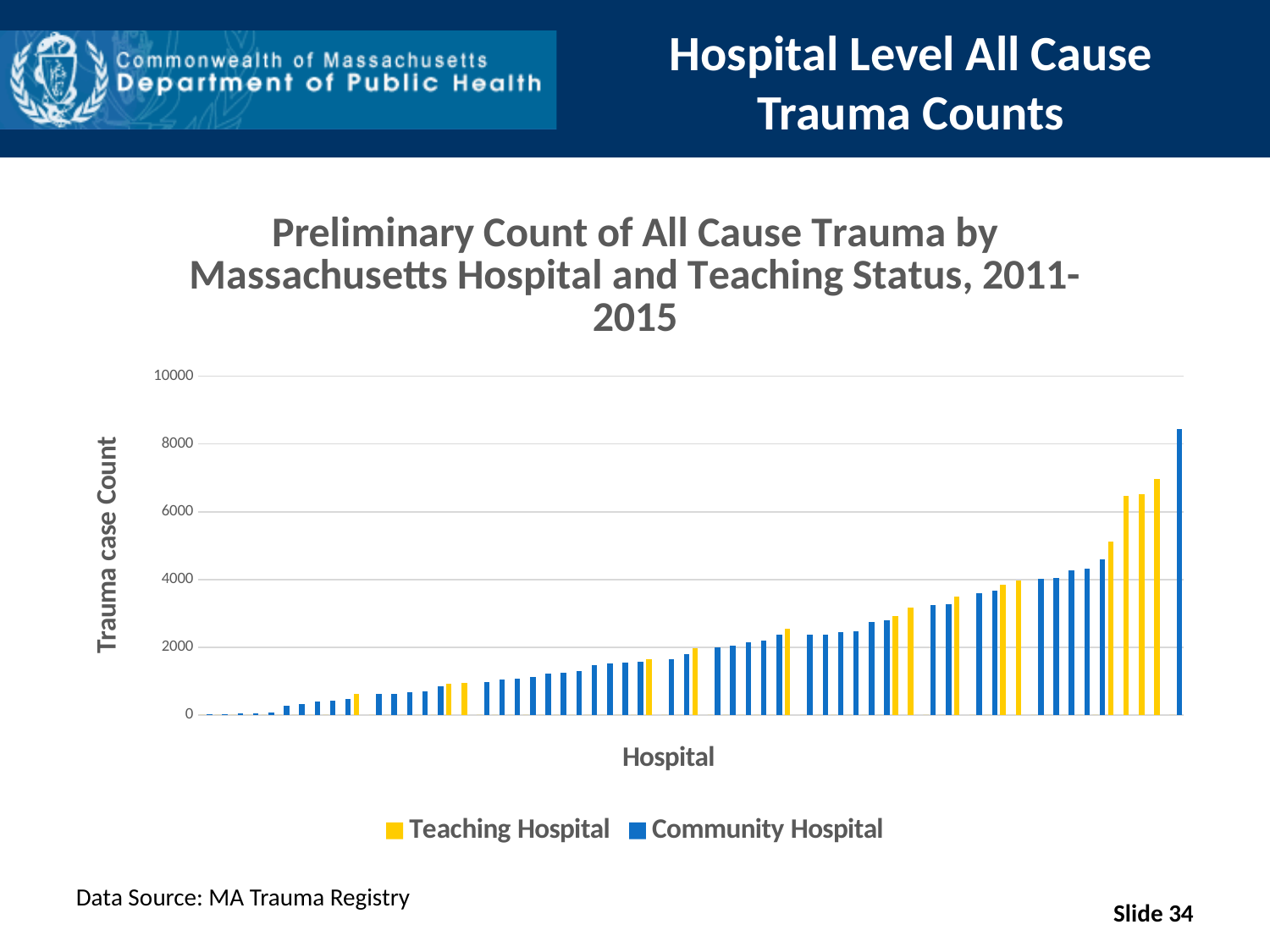
Do the bar values rise or fall from left to right along the x axis? rise Which series has the higher maximum value, Teaching Hospital or Community Hospital? Community Hospital Is the value of the tallest bar greater or less than 8000? greater How many series does the legend list? 2 Is the value of the tallest Teaching Hospital bar greater or less than 6000? greater What is the title of the chart? Preliminary Count of All Cause Trauma by Massachusetts Hospital and Teaching Status, 2011-2015 What is the highest value shown on the y axis? 10000 Which series does the tallest bar in the chart belong to? Community Hospital Is the value of the tallest Teaching Hospital bar greater or less than 8000? less What kind of chart is shown on the slide? bar chart What are the two series named in the legend? Teaching Hospital and Community Hospital